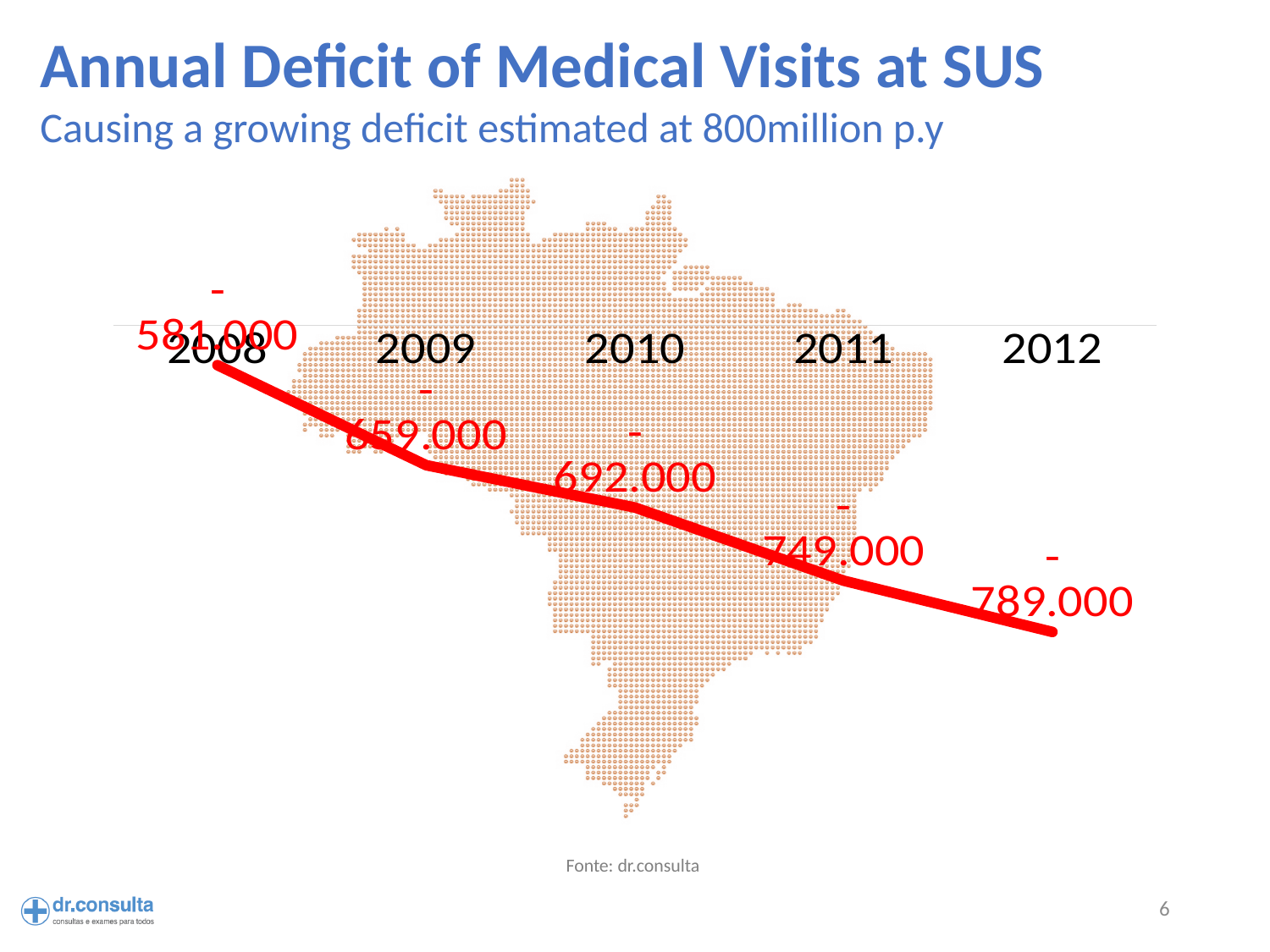
By how much does the deficit figure for 2012 exceed that for 2008 in absolute terms? 208.000 What is the value plotted for 2011? -749.000 What is the absolute difference between the 2009 and 2008 figures? 78.000 What is the value plotted for 2008? -581.000 Do the plotted values rise or fall from 2008 to 2012? fall How many years are plotted on the x axis? 5 Is the deficit figure for 2011 larger or smaller in absolute terms than the figure for 2010? larger Which year has the highest plotted value (the smallest deficit)? 2008 Which year has the lowest plotted value (the largest deficit)? 2012 What kind of chart is shown on the slide? line chart What is the value plotted for 2010? -692.000 What is the value plotted for 2012? -789.000